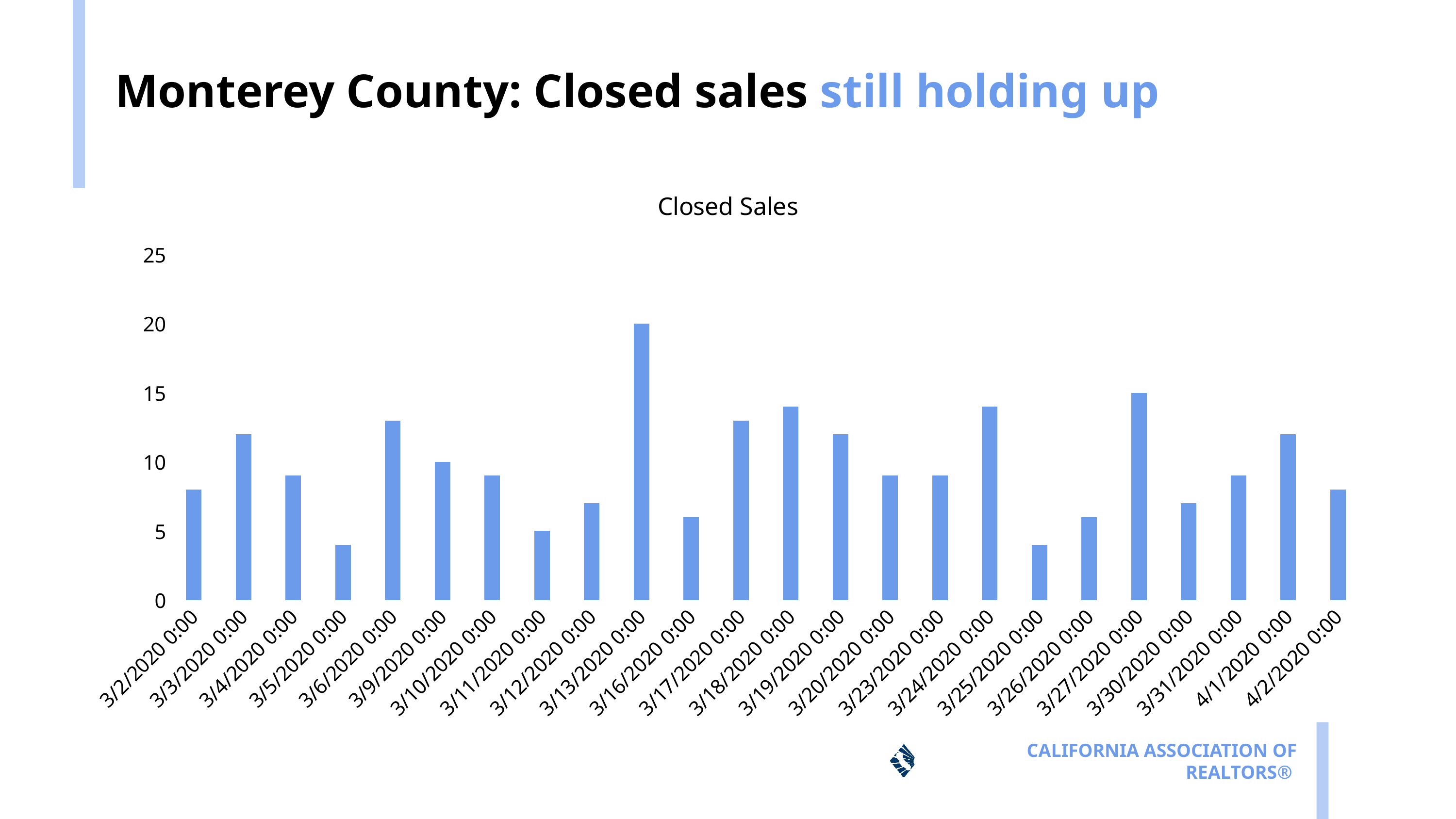
Which date has the highest closed sales value? 3/13/2020 0:00 What is the title of the chart? Closed Sales What is the closed sales value for 3/9/2020 0:00? 10 Is the value for 3/16/2020 0:00 greater or less than 10? less Is the value for 3/5/2020 0:00 greater or less than 5? less How many dates are plotted on the x axis of the chart? 24 What is the closed sales value for 3/27/2020 0:00? 15 What kind of chart is shown on the slide? bar chart What is the closed sales value for 3/13/2020 0:00? 20 Which is larger, the value for 3/3/2020 0:00 or the value for 3/25/2020 0:00? 3/3/2020 0:00 Is the value for 3/18/2020 0:00 greater or less than 10? greater What is the closed sales value for 3/11/2020 0:00? 5